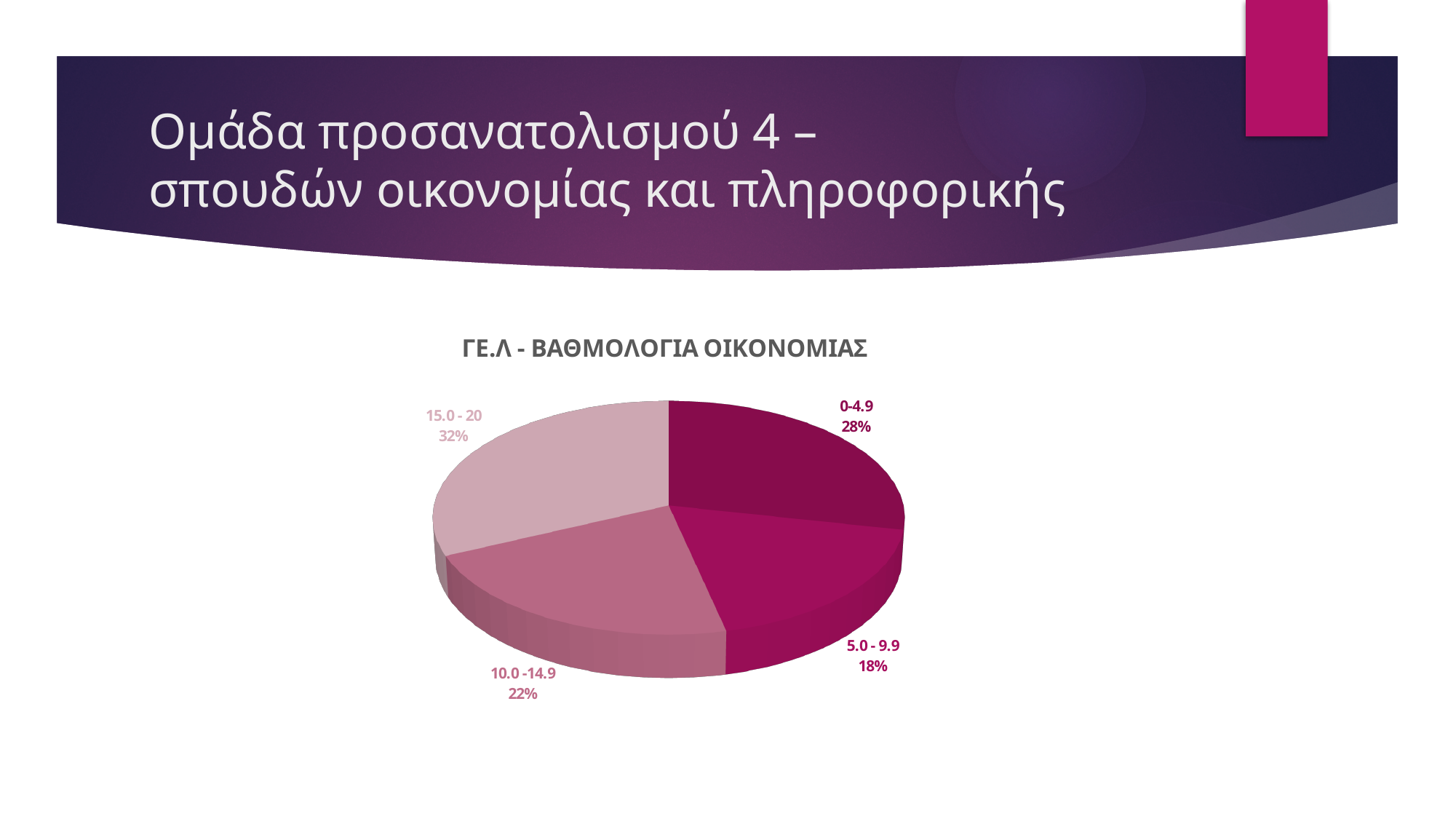
What is the difference in percentage points between the 15.0 - 20 slice and the 5.0 - 9.9 slice? 14 percentage points How many slices does the pie chart have? 4 What share of the pie does the 0-4.9 slice represent? 28% Which slice is larger, 0-4.9 or 10.0 -14.9? 0-4.9 What share of the pie does the 15.0 - 20 slice represent? 32% What is the combined share of the 0-4.9 and 5.0 - 9.9 slices? 46% Which category has the smallest share of the pie? 5.0 - 9.9 What share of the pie does the 10.0 -14.9 slice represent? 22% Which category has the largest share of the pie? 15.0 - 20 What kind of chart is shown on the slide? Pie chart What is the title of the chart? ΓΕ.Λ - ΒΑΘΜΟΛΟΓΙΑ ΟΙΚΟΝΟΜΙΑΣ